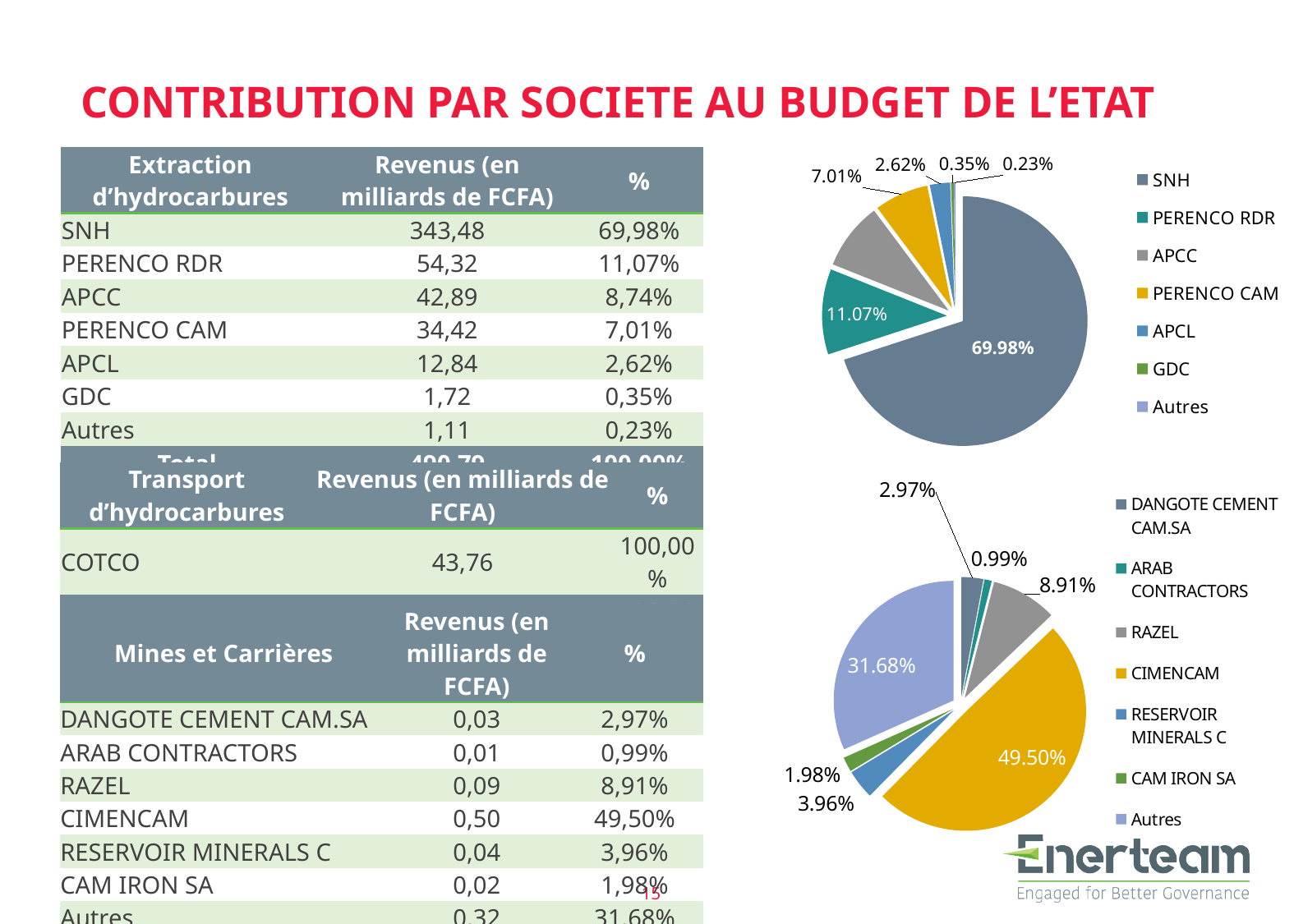
In the upper pie chart, which company has the largest slice? SNH In the upper pie chart, what share does SNH have? 69.98% In the lower pie chart, which is larger: the RAZEL slice or the RESERVOIR MINERALS C slice? RAZEL How many entries does the legend of the upper pie chart list? 7 In the lower pie chart, what share does Autres have? 31.68% In the upper pie chart, what share does PERENCO RDR have? 11.07% In the upper pie chart, what is the difference between the SNH share and the PERENCO RDR share? 58.91% In the lower pie chart, which company has the smallest slice? ARAB CONTRACTORS In the lower pie chart, what share does CIMENCAM have? 49.50% In the upper pie chart, which category has the smallest slice? Autres What type of chart is the upper chart on the right of the slide? pie chart In the lower pie chart, what colour is the CIMENCAM slice? yellow